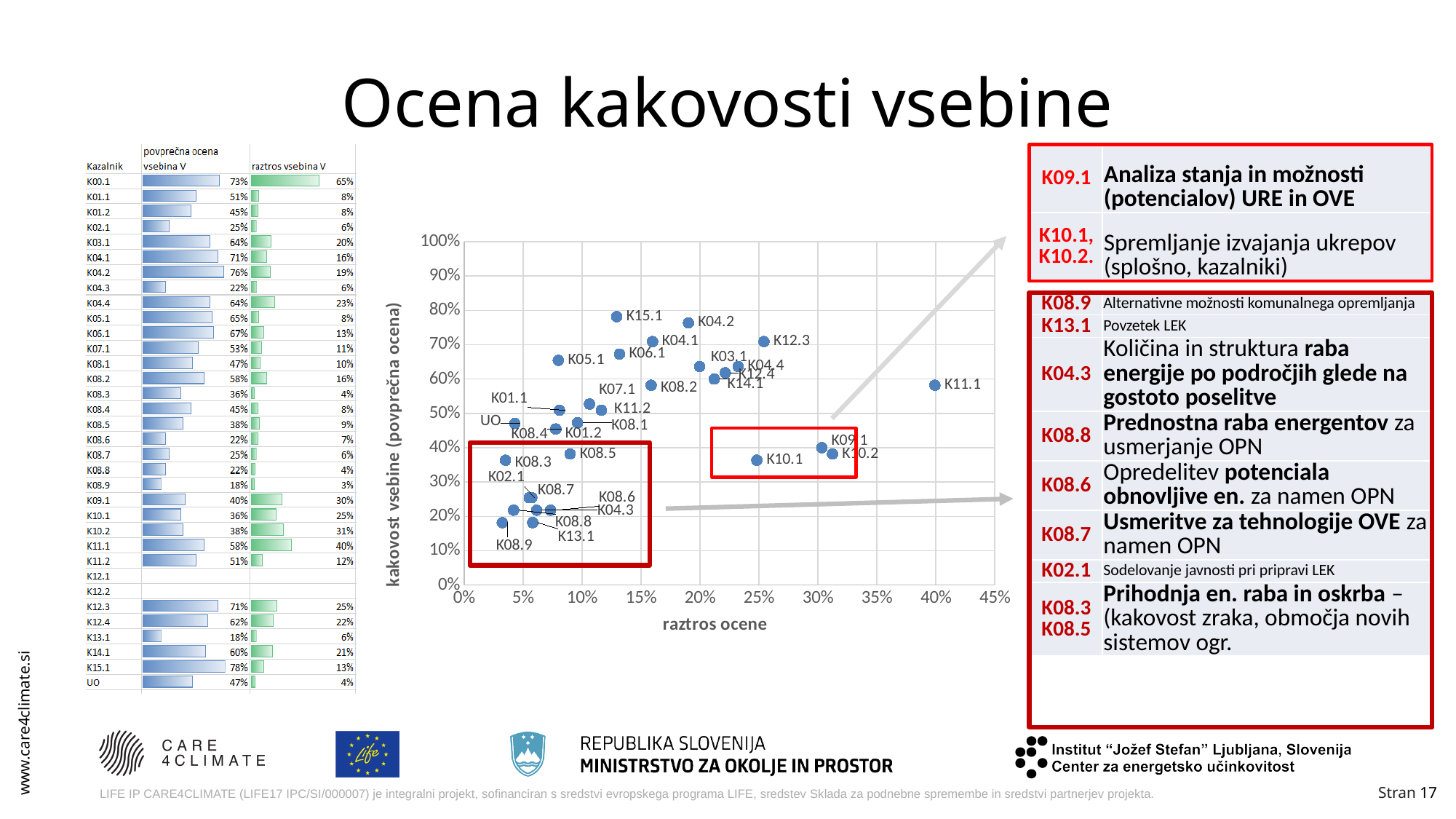
In the table on the left, what is the povprečna ocena vsebina V value for K00.1? 73% In the scatter chart, which point has a higher kakovost vsebine value, K15.1 or K08.3? K15.1 In the scatter chart, is the raztros ocene value for K04.3 greater or less than 10%? less In the scatter chart, is the raztros ocene value for K09.1 greater or less than 25%? greater In the scatter chart, is the raztros ocene value for K11.1 greater or less than 35%? greater In the scatter chart, what is the title of the horizontal axis? raztros ocene In the scatter chart, which labelled point has the highest value on the horizontal axis (raztros ocene)? K11.1 In the scatter chart, what is the title of the vertical axis? kakovost vsebine (povprečna ocena) In the table on the left, what is the raztros vsebina V value for K11.1? 40% What kind of chart is the large chart in the centre of the slide? scatter chart